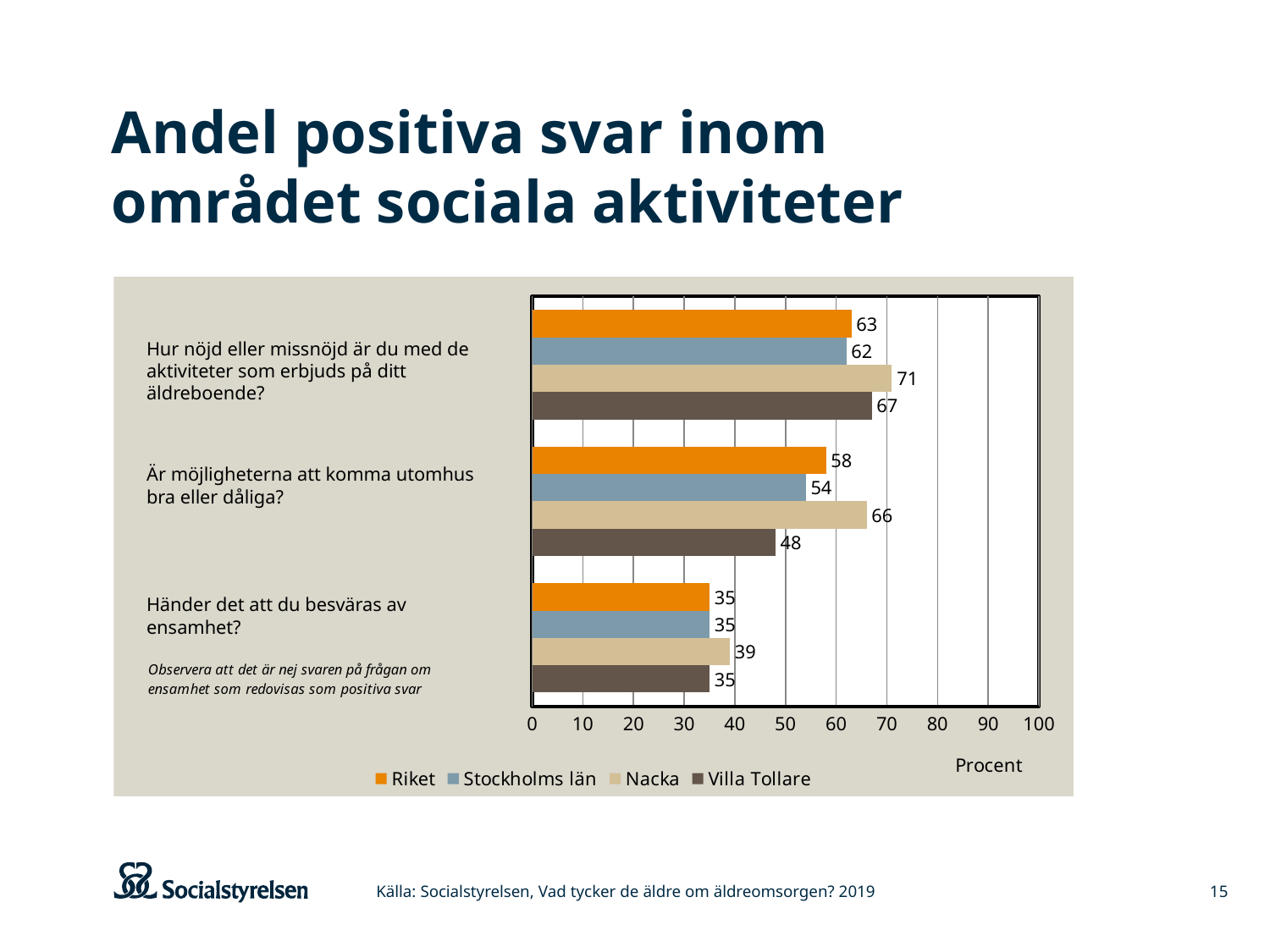
What value does Riket have for the question "Händer det att du besväras av ensamhet?"? 35 For the question "Hur nöjd eller missnöjd är du med de aktiviteter som erbjuds på ditt äldreboende?", which is larger: the Nacka value or the Villa Tollare value? Nacka What unit is shown on the horizontal axis of the chart? Procent What kind of chart is shown on the slide? Bar chart How many series does the legend list? 4 Which series has the lowest value for the question "Är möjligheterna att komma utomhus bra eller dåliga?"? Villa Tollare What value does Villa Tollare have for the question "Är möjligheterna att komma utomhus bra eller dåliga?"? 48 What is the difference between the Nacka and Villa Tollare values for the question "Är möjligheterna att komma utomhus bra eller dåliga?"? 18 What value does Nacka have for the question "Hur nöjd eller missnöjd är du med de aktiviteter som erbjuds på ditt äldreboende?"? 71 Which series has the highest value for the question "Är möjligheterna att komma utomhus bra eller dåliga?"? Nacka Is the Stockholms län value for the question "Är möjligheterna att komma utomhus bra eller dåliga?" greater or less than 50? greater How many questions (categories) are shown on the chart? 3